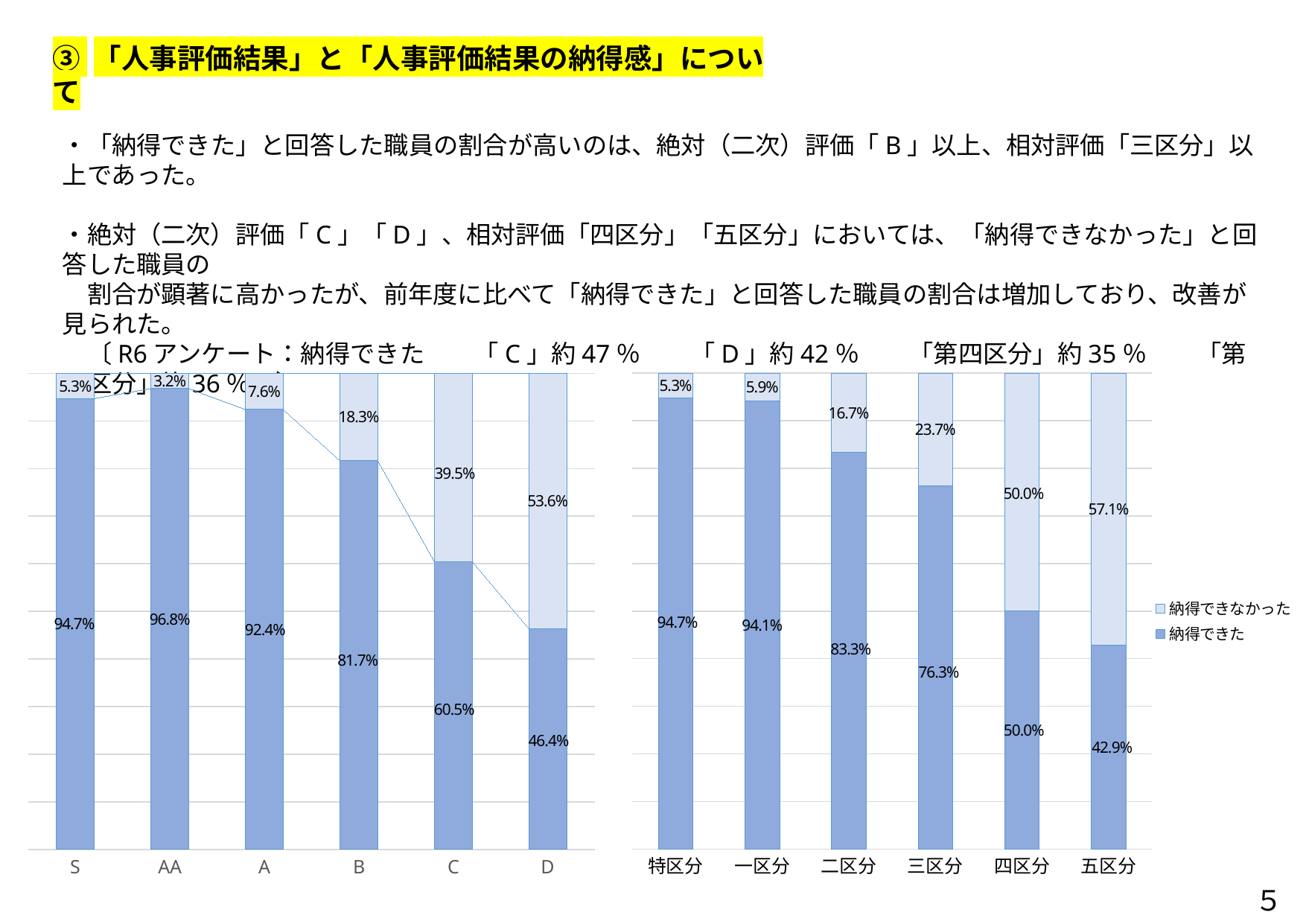
How many series does the legend list? 2 In the right chart, what is the 納得できた value for 三区分? 76.3% In the left chart, what is the 納得できた value for category C? 60.5% In the left chart, which category has the highest 納得できた value? AA In the left chart, what is the 納得できなかった value for category D? 53.6% In the right chart, does the 納得できた value rise or fall from 特区分 to 五区分? Fall What kind of chart is the right chart? Stacked bar chart In the right chart, what is the 納得できなかった value for 二区分? 16.7% How many categories are shown on the x axis of the left chart? 6 In the right chart, which is larger: the 納得できなかった value for 四区分 or for 三区分? 四区分 In the right chart, which category has the lowest 納得できた value? 五区分 In the left chart, what is the difference between the 納得できた values for B and C? 21.2%